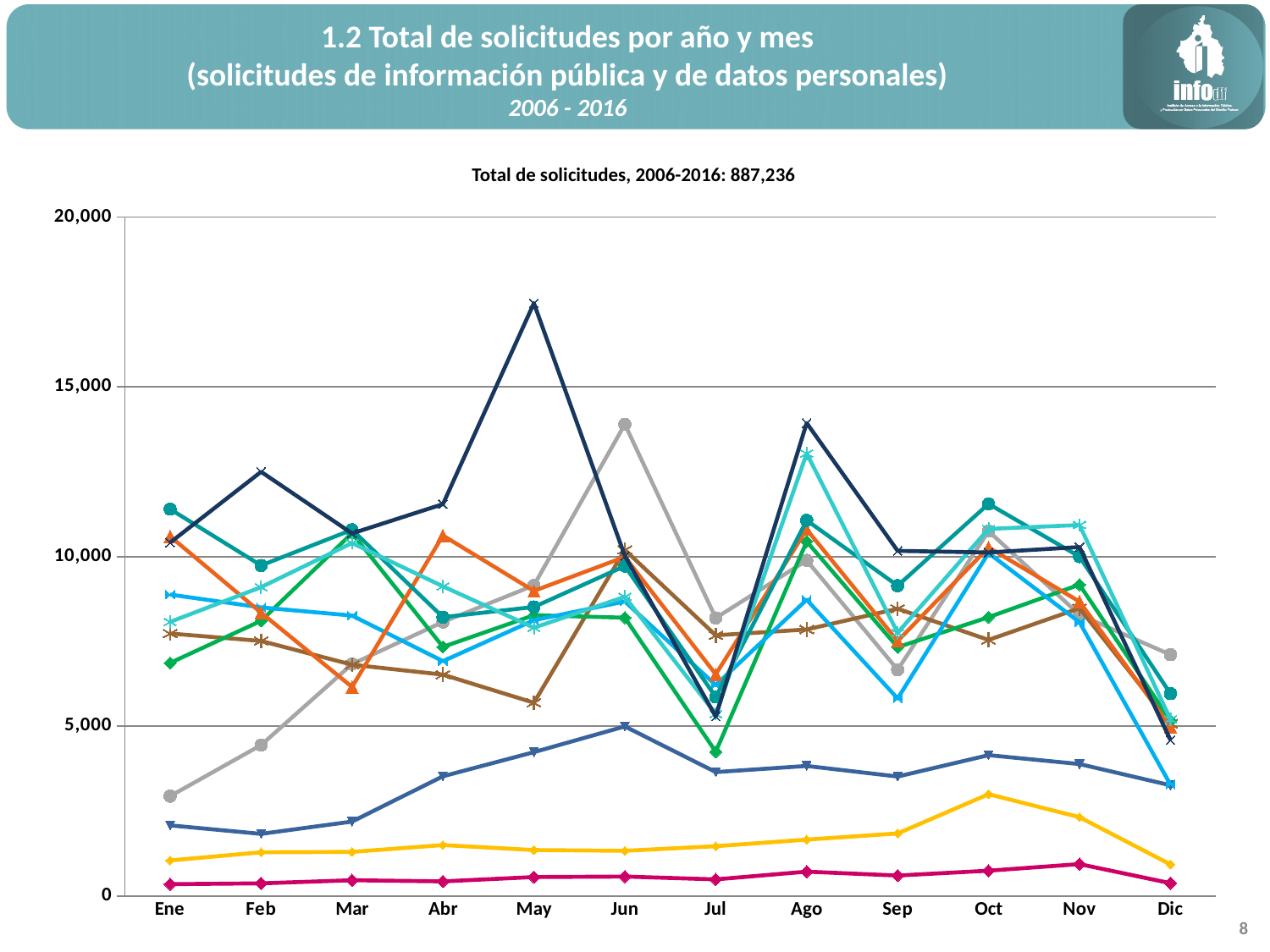
Is the highest value plotted for Jun greater or less than 10,000? greater What kind of chart is shown on the slide? line chart Is the highest point plotted on the chart greater or less than 20,000? less What total of solicitudes for 2006-2016 is stated in the chart title? 887,236 In which month does the highest point on the chart occur? May What is the highest value shown on the y axis of the chart? 20,000 Is the highest point plotted on the chart greater or less than 15,000? greater How many months are shown along the x axis of the chart? 12